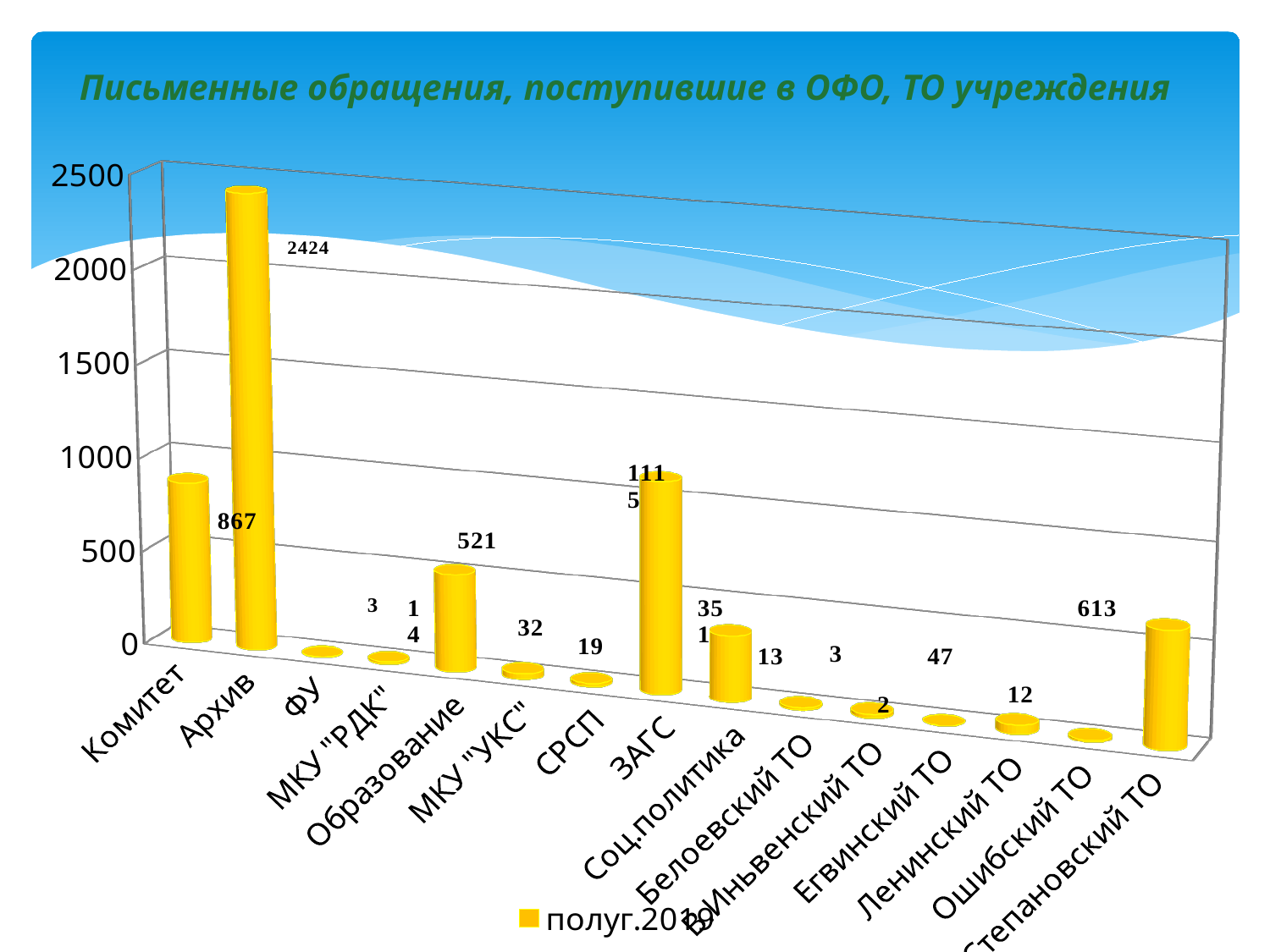
Which is larger, the value for ЗАГС or the value for Степановский ТО? ЗАГС What is the title of the chart? Письменные обращения, поступившие в ОФО, ТО учреждения What is the value for Архив? 2424 Which category has the highest value? Архив How many categories are shown on the x axis? 15 What is the difference between the values for Архив and Комитет? 1557 What kind of chart is shown on the slide? bar chart What is the value for Степановский ТО? 613 How many series does the legend list? 1 Is the value for Архив greater or less than 2000? greater What is the value for Образование? 521 What is the value for Комитет? 867